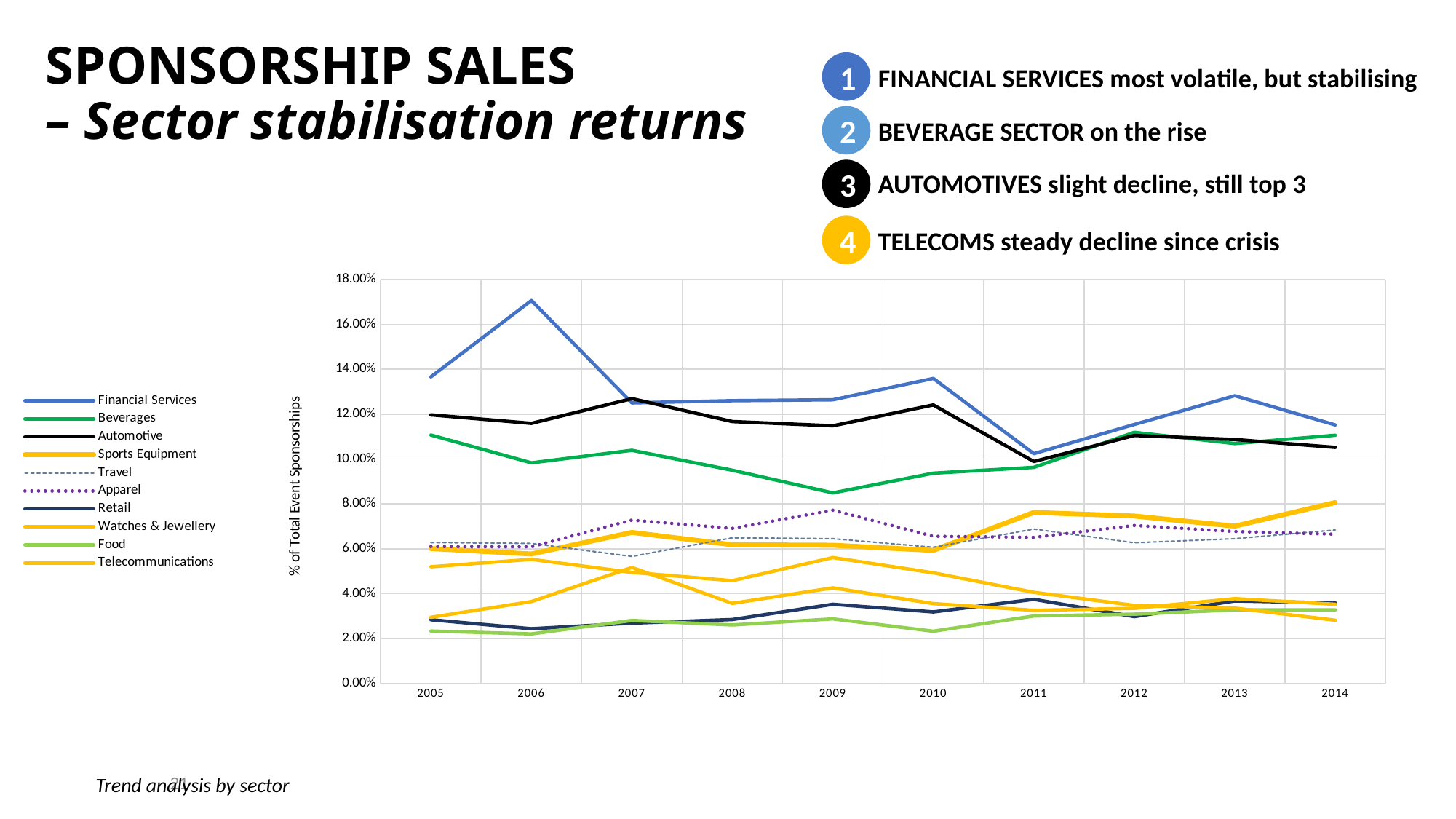
Does the Beverages line rise or fall from 2009 to 2014? rise In 2005, which is higher: Automotive or Beverages? Automotive What is the title of the chart's vertical axis? % of Total Event Sponsorships What kind of chart is shown on the slide? line chart How many years are plotted along the x axis of the chart? 10 Is the value for Financial Services in 2006 greater or less than 16.00%? greater How many series does the chart's legend list? 10 Is the value for Beverages in 2009 greater or less than 10.00%? less In 2010, which is higher: Financial Services or Automotive? Financial Services Is the value for Financial Services in 2011 greater or less than 12.00%? less Which series has the lowest value in 2010? Food Which series has the highest value in 2006? Financial Services